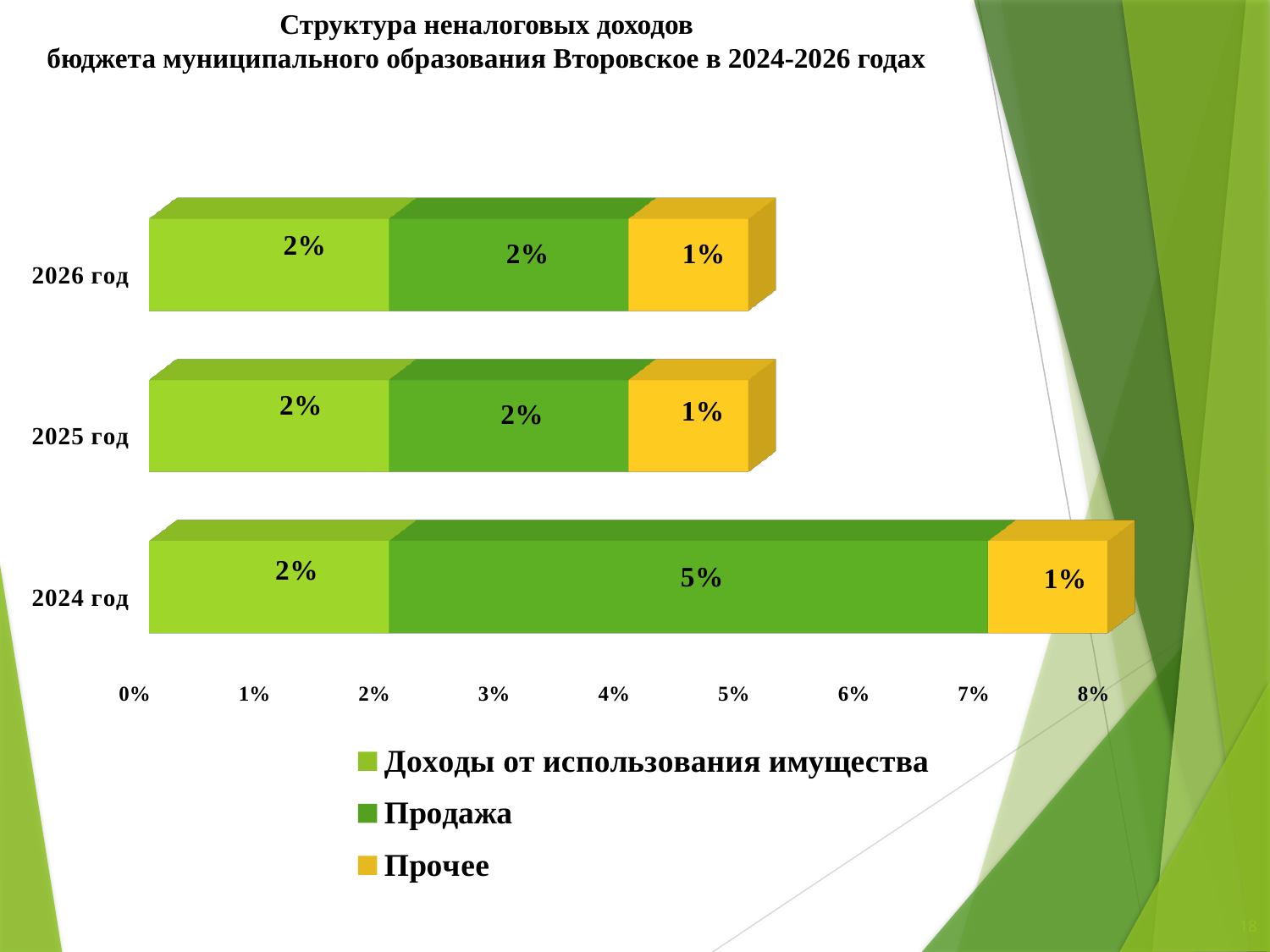
What kind of chart is shown on the slide? Stacked bar chart What is the total of the stacked bar for 2026 год? 5% How many years (categories) are shown on the chart? 3 What is the value for Продажа in 2024 год? 5% What is the difference between the Продажа value in 2024 год and in 2025 год? 3% How many series does the legend list? 3 What is the value for Прочее in 2025 год? 1% What is the value for Доходы от использования имущества in 2026 год? 2% Which is larger in 2024 год: Продажа or Прочее? Продажа In which year is the value for Продажа the highest? 2024 год Which series is shown in yellow in the legend? Прочее What is the total of the stacked bar for 2024 год? 8%